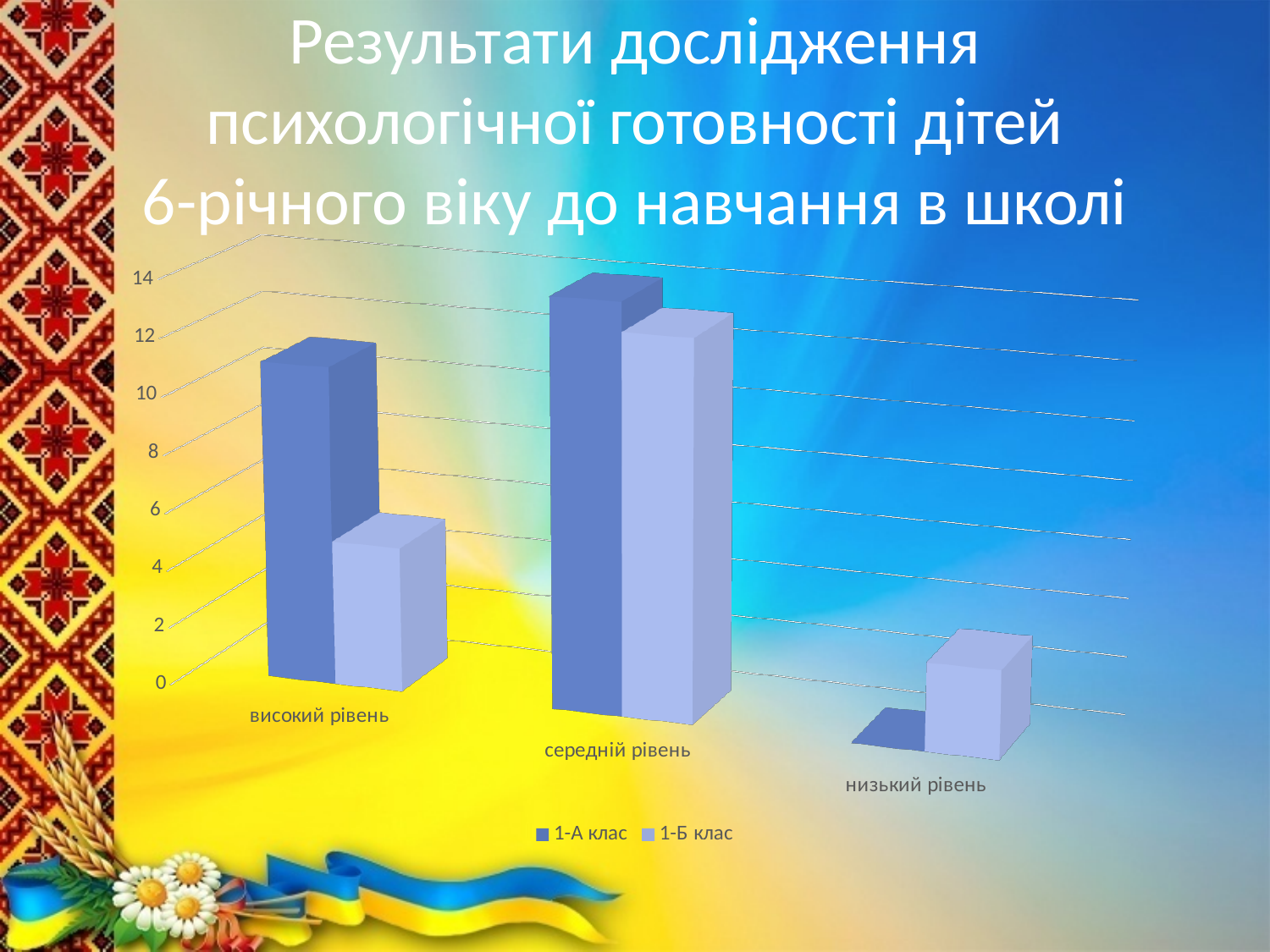
Is the value for 1-А клас in the середній рівень category greater or less than 10? greater In the високий рівень category, which series has the larger value, 1-А клас or 1-Б клас? 1-А клас How many series does the chart legend list? 2 In the низький рівень category, which series has the larger value, 1-А клас or 1-Б клас? 1-Б клас For which category is the 1-А клас bar the highest? середній рівень For which category is the 1-А клас bar the lowest? низький рівень How many categories are shown on the x axis of the chart? 3 What are the two series named in the chart legend? 1-А клас and 1-Б клас Is the value for 1-Б клас in the високий рівень category greater or less than 8? less What kind of chart is shown on the slide? bar chart For which category is the 1-Б клас bar the highest? середній рівень For which category is the 1-Б клас bar the lowest? низький рівень